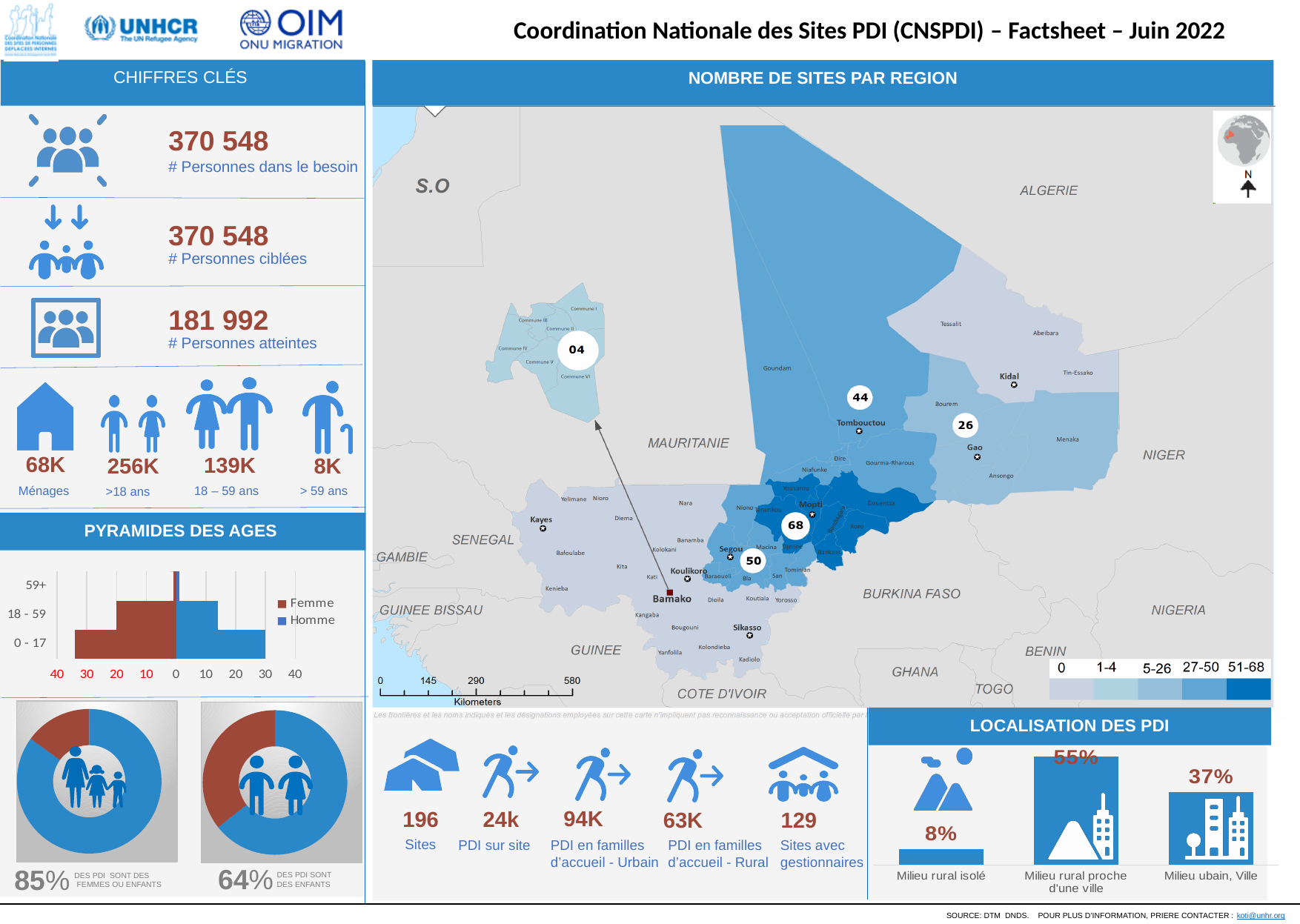
In the LOCALISATION DES PDI chart, what percentage is shown for Milieu rural proche d'une ville? 55% How many series does the legend of the PYRAMIDES DES AGES chart list? 2 How many categories are shown in the LOCALISATION DES PDI chart? 3 In the LOCALISATION DES PDI chart, which category has the lowest value? Milieu rural isolé In the PYRAMIDES DES AGES chart, which age group has the largest bars for both Femme and Homme? 0 - 17 In the LOCALISATION DES PDI chart, what is the difference between the values for Milieu rural proche d'une ville and Milieu ubain, Ville? 18% What kind of chart is the PYRAMIDES DES AGES chart? bar chart In the LOCALISATION DES PDI chart, what percentage is shown for Milieu rural isolé? 8% In the PYRAMIDES DES AGES chart, is the Homme value for the 18 - 59 age group greater or less than 20? less In the NOMBRE DE SITES PAR REGION map, how many sites are shown for the Mopti region? 68 In the LOCALISATION DES PDI chart, which category has the highest value? Milieu rural proche d'une ville In the PYRAMIDES DES AGES chart, is the Femme value for the 0 - 17 age group greater or less than 20? greater